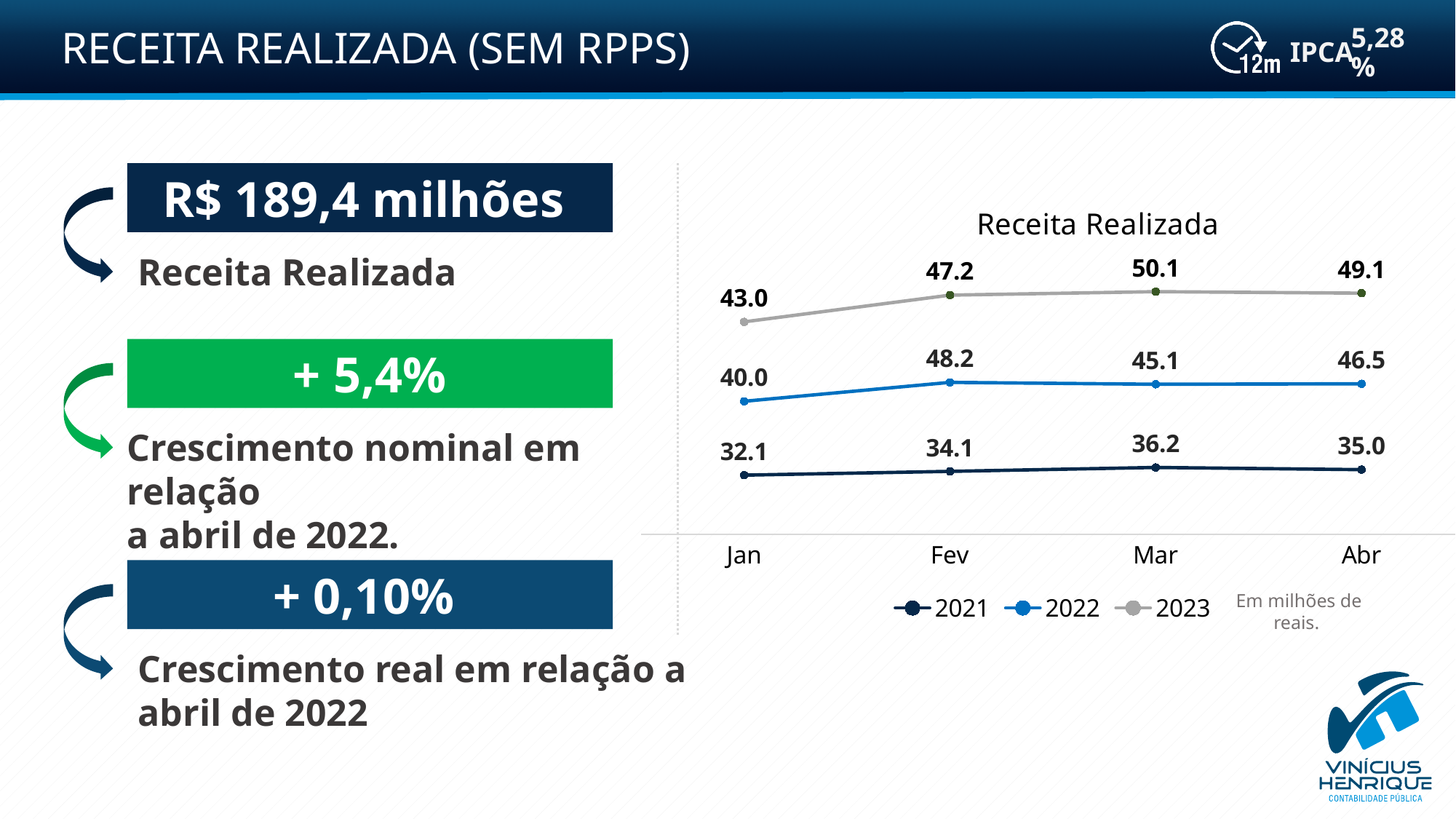
How many months are shown on the x axis? 4 What is the value for 2023 in Mar? 50.1 Which is larger in Fev: the 2022 value or the 2023 value? 2022 What kind of chart is shown? line chart In which month is the 2022 series lowest? Jan What is the title of the chart? Receita Realizada How many series does the legend list? 3 Does the 2021 series rise or fall from Jan to Mar? rise What is the difference between the 2023 and 2022 values in Abr? 2.6 What is the value for 2022 in Fev? 48.2 In which month is the 2023 series highest? Mar What is the value for 2021 in Jan? 32.1